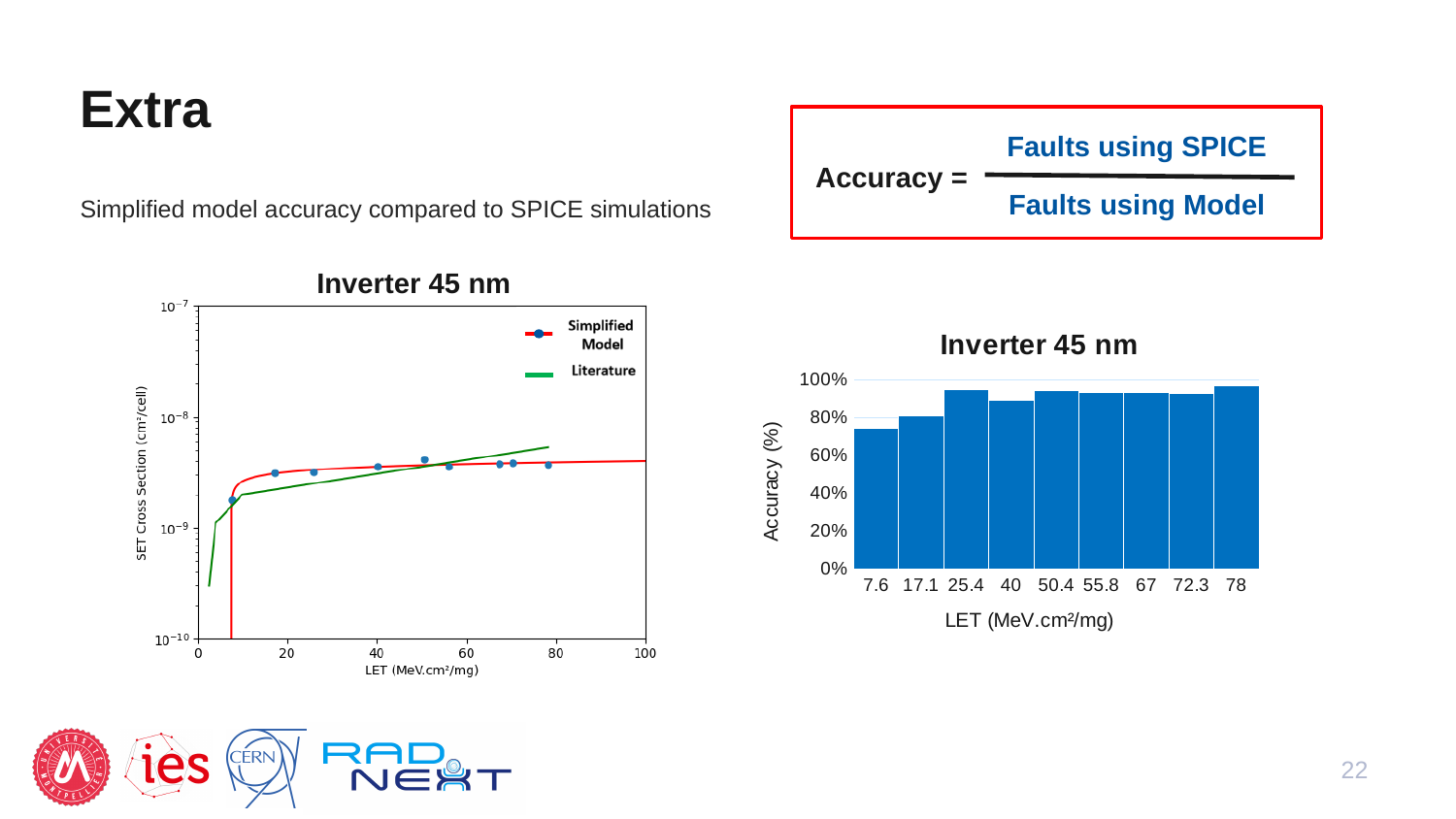
What kind of chart is the chart on the left of the slide? line chart On the bar chart on the right, is the accuracy for LET 78 greater or less than 80%? greater On the bar chart on the right, how many LET categories are shown on the x axis? 9 How many series does the legend of the chart on the left list? 2 On the bar chart on the right, is the accuracy for LET 7.6 greater or less than 80%? less On the chart on the left, does the Simplified Model curve rise or fall as LET increases? rise What is the y-axis label of the bar chart on the right? Accuracy (%) On the bar chart on the right, which LET value has the lowest accuracy? 7.6 On the bar chart on the right, is the accuracy for LET 25.4 greater or less than 80%? greater On the bar chart on the right, which has the higher accuracy, LET 7.6 or LET 25.4? 25.4 What kind of chart is the chart on the right of the slide? bar chart On the bar chart on the right, which has the higher accuracy, LET 17.1 or LET 40? 40